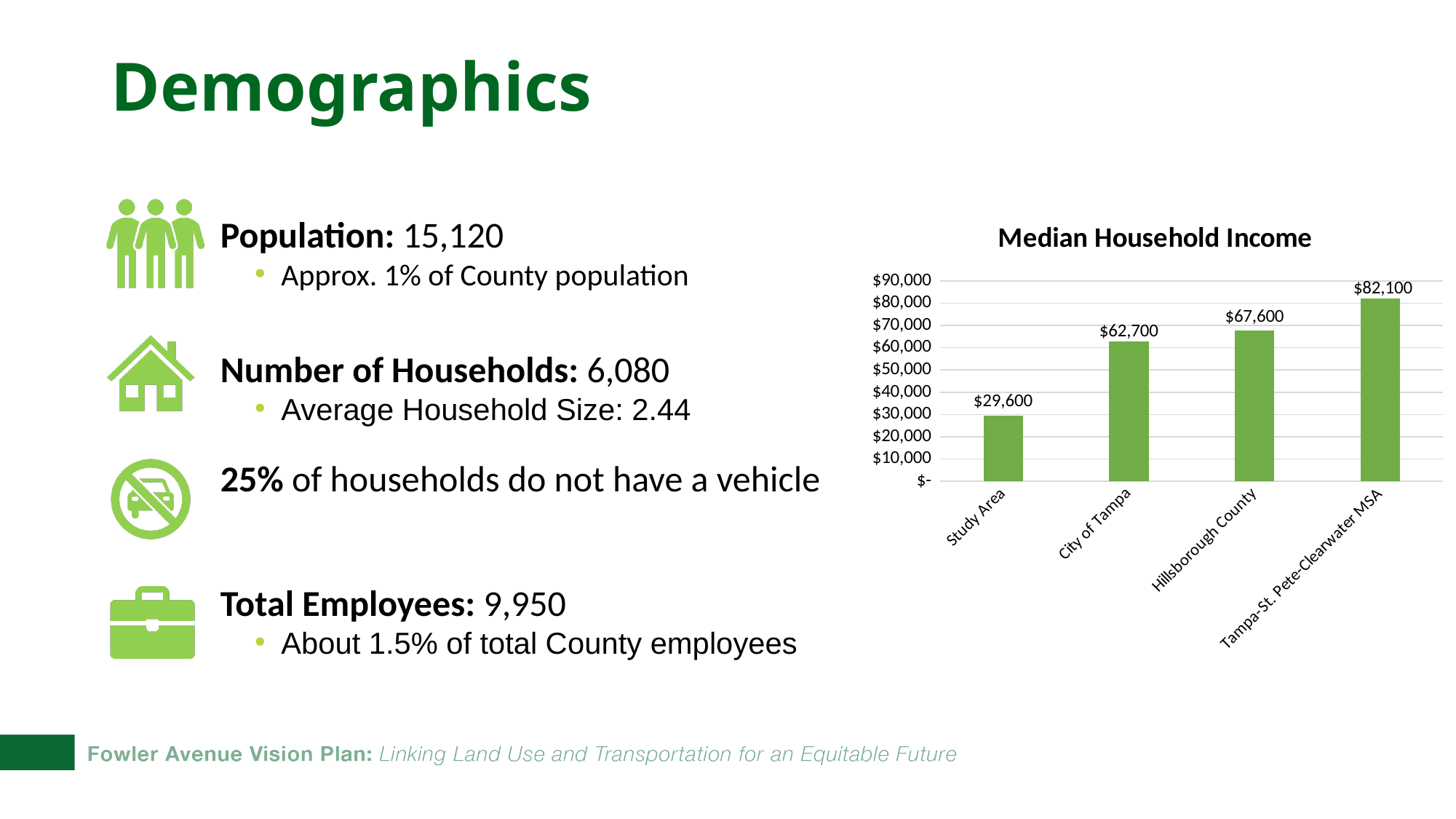
What is the median household income for the City of Tampa? $62,700 Which category has the highest median household income? Tampa-St. Pete-Clearwater MSA What kind of chart is the Median Household Income chart? Bar chart What is the difference in median household income between the Tampa-St. Pete-Clearwater MSA and the City of Tampa? $19,400 Which has a higher median household income, the City of Tampa or Hillsborough County? Hillsborough County What is the median household income for the Tampa-St. Pete-Clearwater MSA? $82,100 What is the median household income for the Study Area? $29,600 What is the difference in median household income between Hillsborough County and the Study Area? $38,000 Which category has the lowest median household income? Study Area What is the median household income for Hillsborough County? $67,600 Do the values in the Median Household Income chart rise or fall from left to right? Rise How many categories are shown in the Median Household Income chart? 4